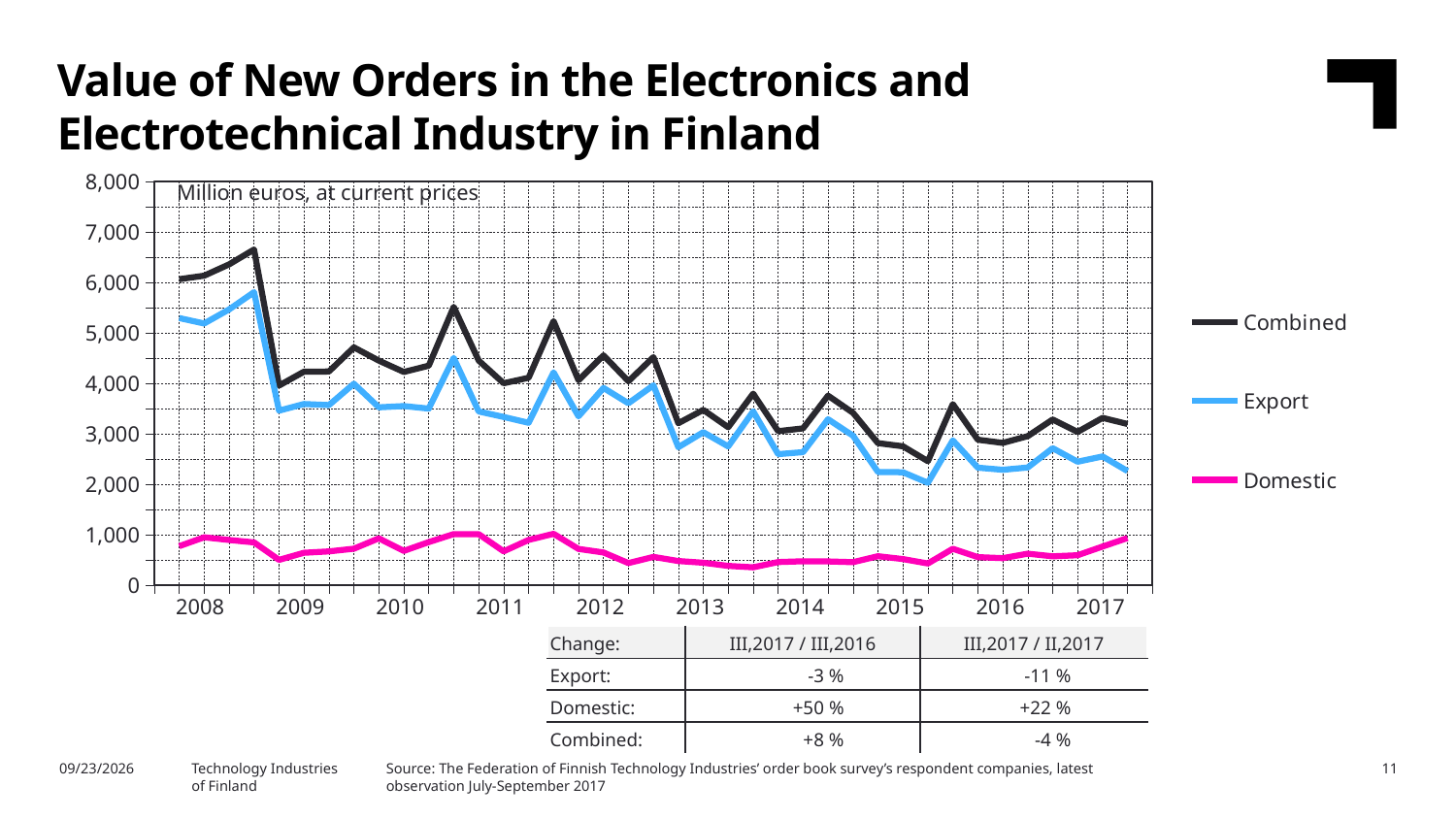
According to the table below the chart, what is the Domestic change for III,2017 / III,2016? +50 % Does the Combined series overall rise or fall from 2008 to 2017? Fall Is the peak value of the Combined series in 2008 greater or less than 7,000? less Is the Export value larger or smaller than the Domestic value in 2017? Larger Which series has the lowest values throughout the chart? Domestic What are the three series named in the legend? Combined, Export, Domestic Which series has the highest values throughout the chart? Combined How many series does the legend list? 3 What unit is stated in the label inside the chart area? Million euros, at current prices Is the Domestic series ever greater than 2,000 at any point on the chart? No What kind of chart is shown on the slide? Line chart How many years are labelled on the x axis? 10